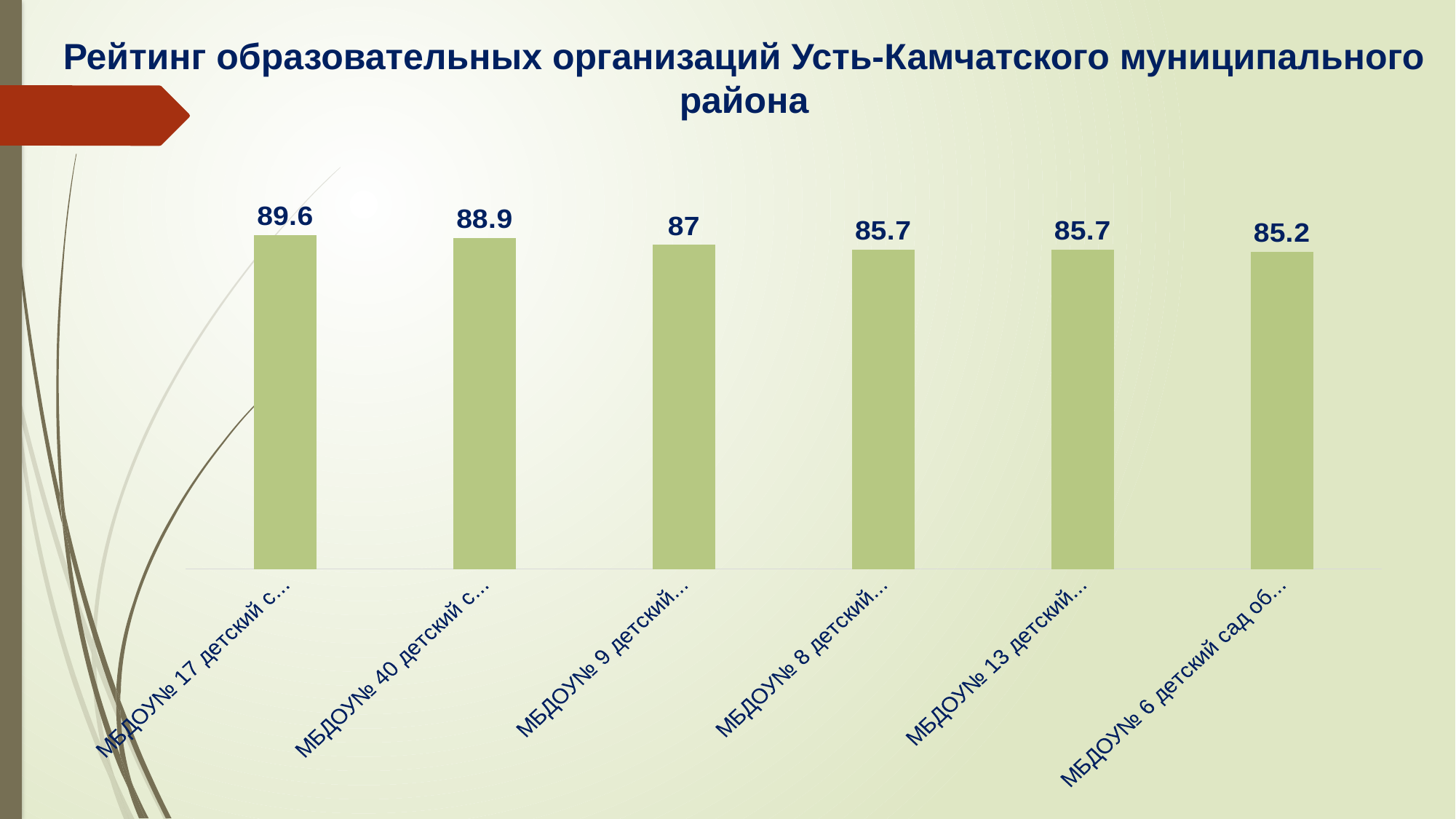
What value is shown for МБДОУ№ 6? 85.2 What is the difference between the values for МБДОУ№ 9 and МБДОУ№ 6? 1.8 Which has a larger value, МБДОУ№ 40 or МБДОУ№ 9? МБДОУ№ 40 What value is shown for МБДОУ№ 17? 89.6 What kind of chart is shown on the slide? Bar chart Which organisation has the highest value in the chart? МБДОУ№ 17 What is the difference between the values for МБДОУ№ 17 and МБДОУ№ 40? 0.7 Do the values rise or fall from left to right across the chart? Fall What value is shown for МБДОУ№ 9? 87 Which organisation has the lowest value in the chart? МБДОУ№ 6 How many bars are shown in the chart? 6 What value is shown for МБДОУ№ 40? 88.9